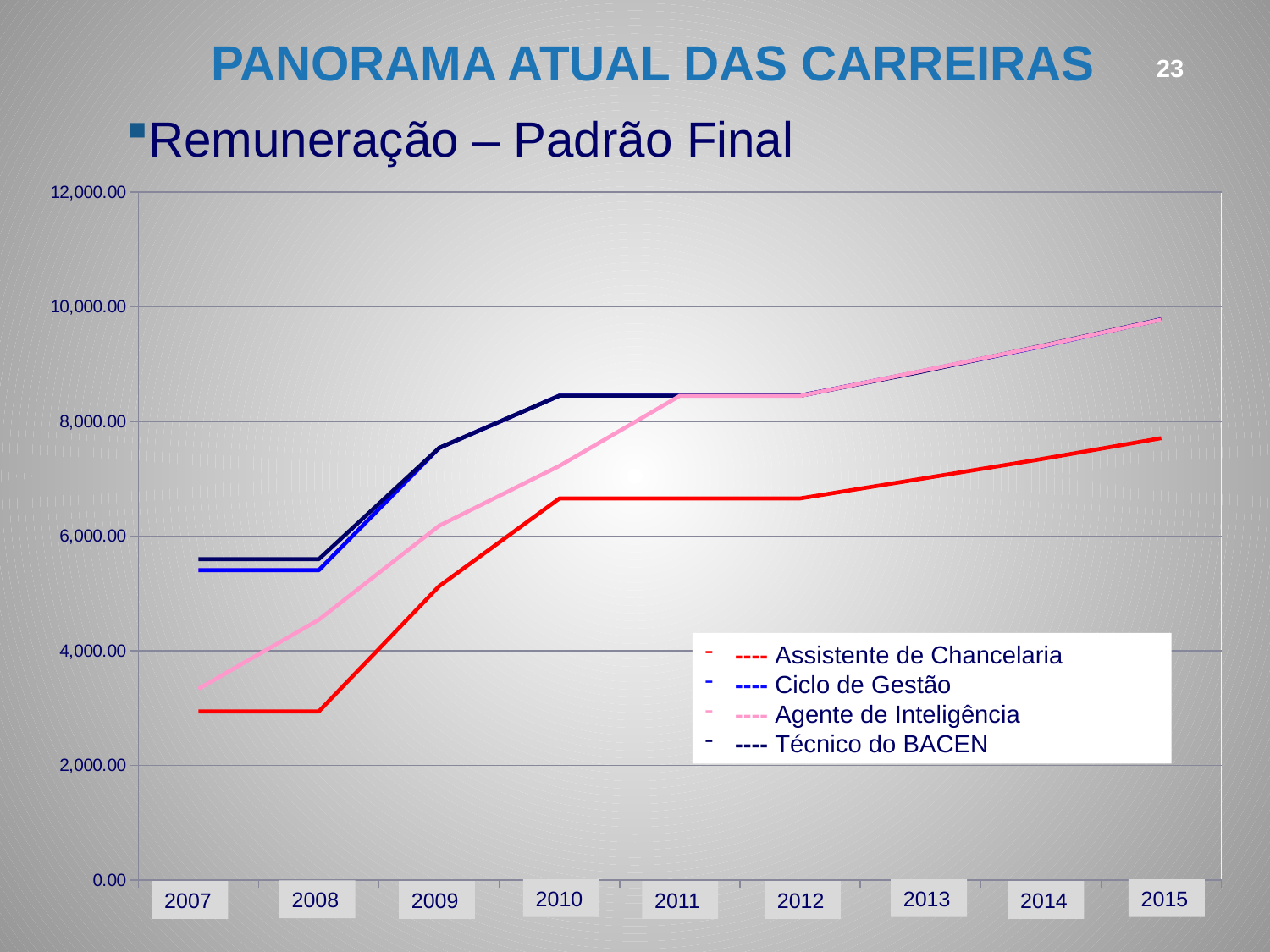
How many years are shown along the x axis? 9 In 2009, which is higher: Agente de Inteligência or Assistente de Chancelaria? Agente de Inteligência What kind of chart is shown on the slide? Line chart Is the value for Agente de Inteligência in 2015 greater or less than 8,000.00? greater What colour is the line for Assistente de Chancelaria? Red Is the value for Ciclo de Gestão in 2009 greater or less than 6,000.00? greater Is the value for Assistente de Chancelaria in 2007 greater or less than 4,000.00? less How many series does the legend list? 4 Does the Assistente de Chancelaria line rise or fall from 2012 to 2015? Rises Which series has the lowest value in 2015? Assistente de Chancelaria In 2007, which is higher: Assistente de Chancelaria or Agente de Inteligência? Agente de Inteligência